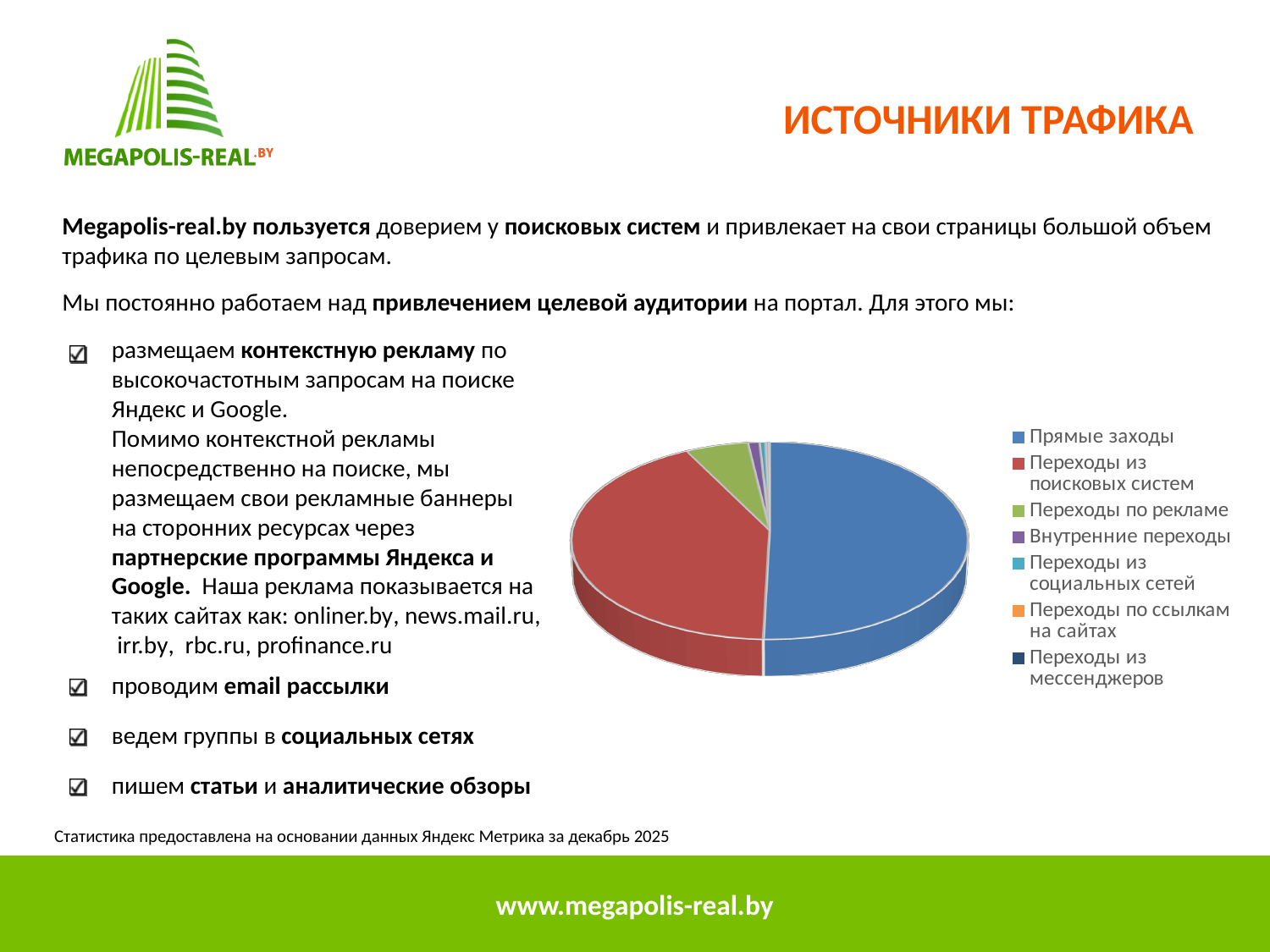
What colour represents Переходы из поисковых систем in the pie chart? red What colour represents Прямые заходы in the pie chart? blue Which slice is larger in the pie chart: Переходы по рекламе or Внутренние переходы? Переходы по рекламе Which category is the second largest slice in the pie chart? Переходы из поисковых систем How many categories does the legend of the pie chart list? 7 Which slice is larger in the pie chart: Переходы из поисковых систем or Переходы по рекламе? Переходы из поисковых систем What kind of chart is shown on the slide? pie chart Which category has the largest slice in the pie chart? Прямые заходы Which slice is larger in the pie chart: Прямые заходы or Переходы из поисковых систем? Прямые заходы